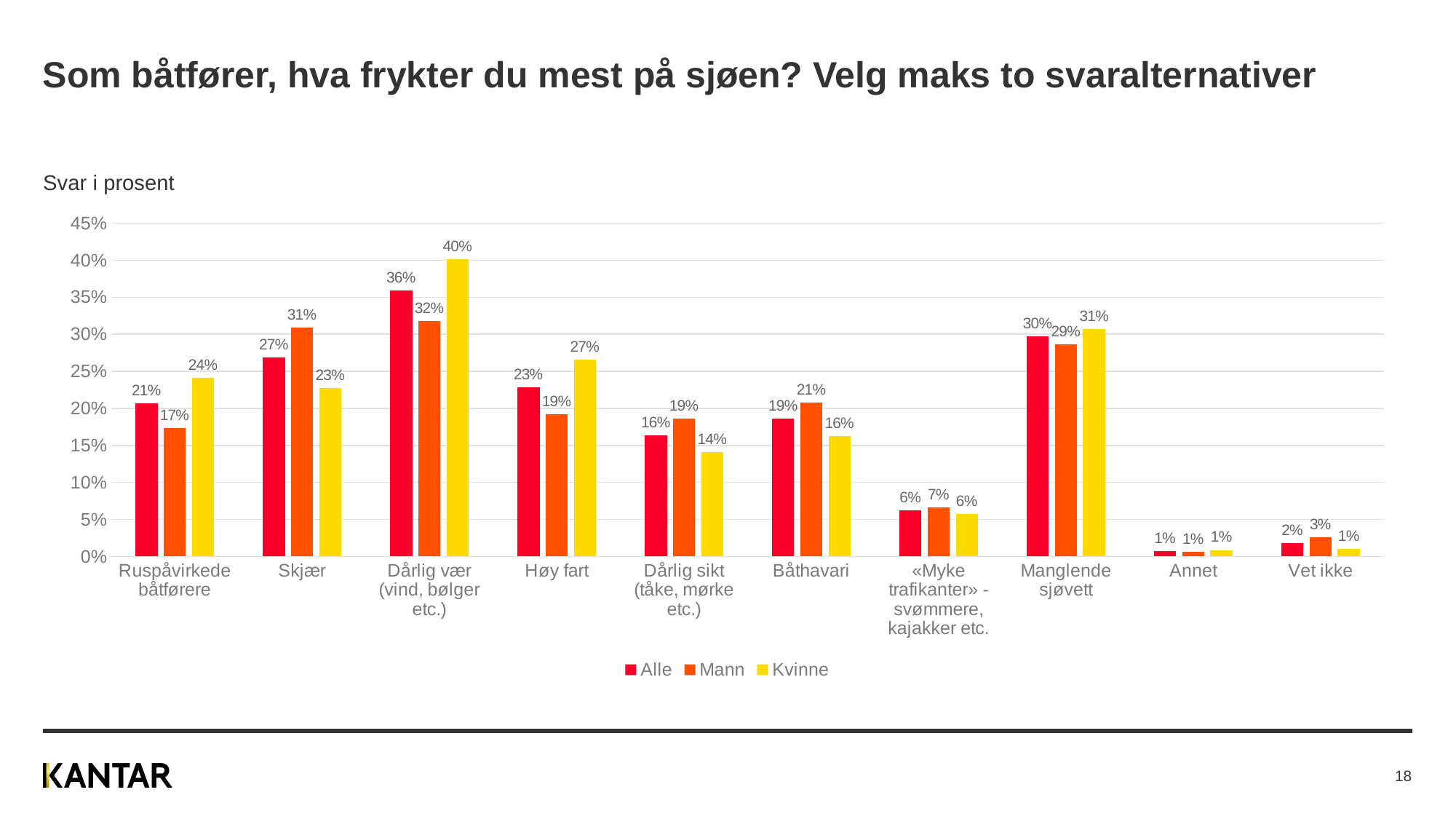
What is the value for Mann in the Skjær category? 31% How many categories are shown on the x axis? 10 Is the value for Mann in the Båthavari category greater or less than 20%? greater How many series does the legend list? 3 Which is larger in the Høy fart category, the Alle value or the Kvinne value? Kvinne What is the difference between the Kvinne and Mann values in the Dårlig vær (vind, bølger etc.) category? 8% Which category has the highest value for the Alle series? Dårlig vær (vind, bølger etc.) What kind of chart is shown on the slide? Bar chart Which series is shown in yellow in the legend? Kvinne What is the value for Kvinne in the Dårlig vær (vind, bølger etc.) category? 40% What is the value for Alle in the Manglende sjøvett category? 30% Which category has the lowest value for the Mann series? Annet